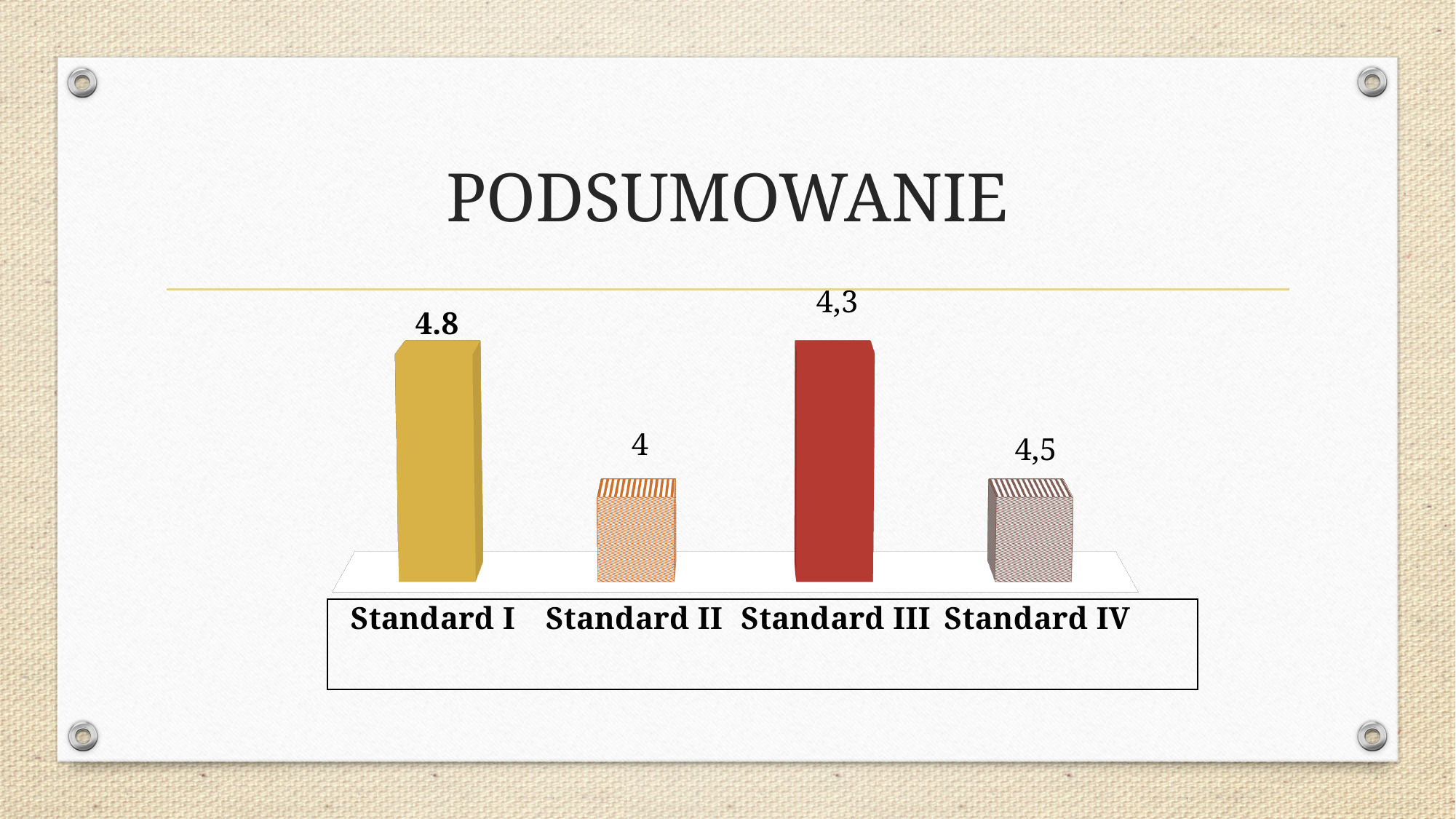
How many categories are shown in the chart? 4 What is the value shown for Standard IV? 4,5 What kind of chart is shown on the slide? bar chart What is the title of the slide containing the chart? PODSUMOWANIE Which is larger, the value for Standard I or the value for Standard IV? Standard I What is the value shown for Standard III? 4,3 What is the value shown for Standard II? 4 What is the difference between the values for Standard IV and Standard II? 0,5 What is the difference between the values for Standard I and Standard II? 0.8 What is the value shown for Standard I? 4.8 Which category has the lowest value? Standard II Which category has the highest value? Standard I